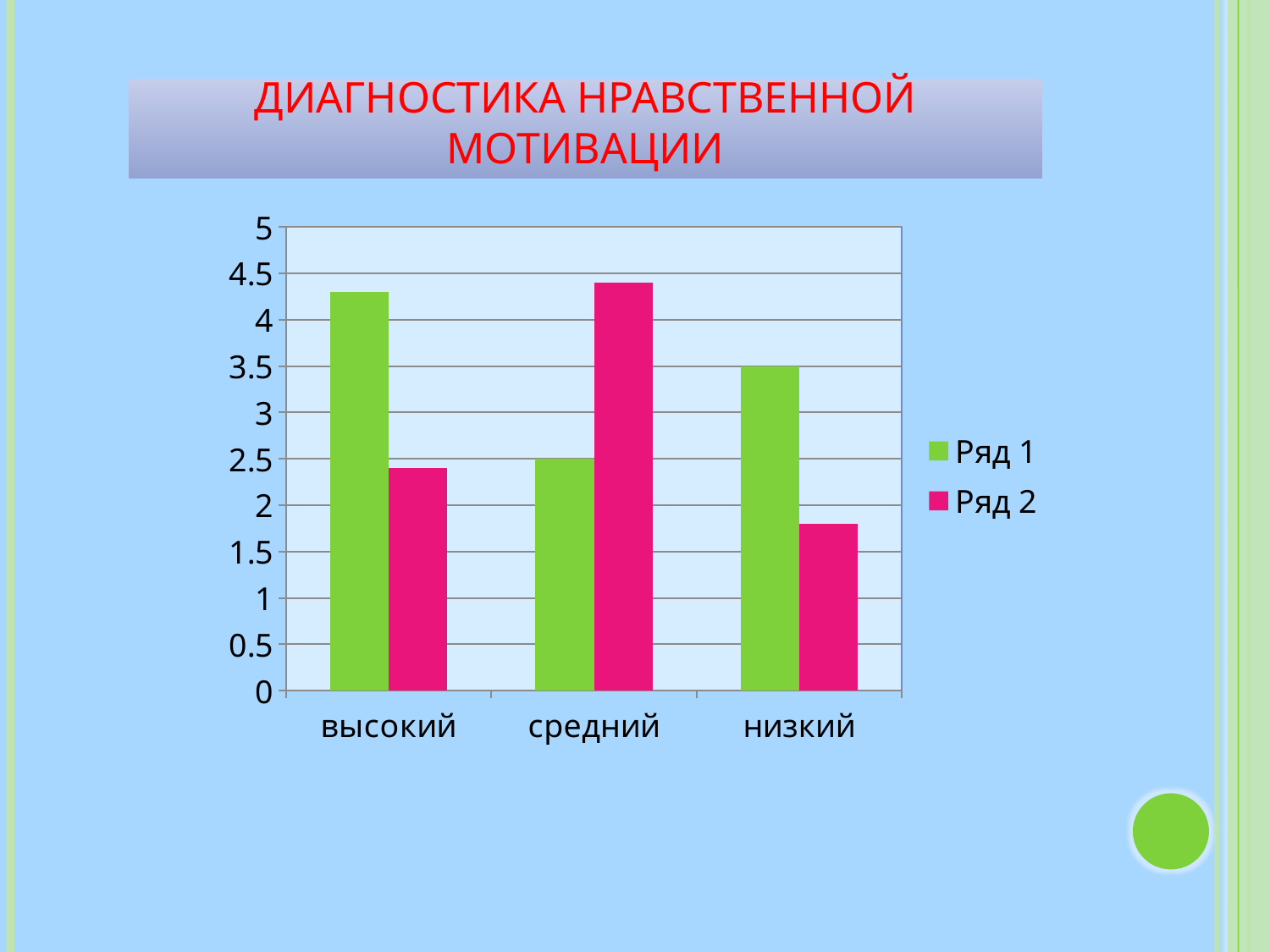
Which category has the lowest value for Ряд 2? низкий Is the value of Ряд 1 for высокий greater or less than 4? greater How many categories are shown on the x axis of the chart? 3 What is the value of Ряд 1 for низкий? 3.5 What colour are the bars for Ряд 2? pink Is the value of Ряд 2 for средний greater or less than 4? greater Is the value of Ряд 2 for низкий greater or less than 2? less For the category высокий, which series has the larger value, Ряд 1 or Ряд 2? Ряд 1 What kind of chart is shown on the slide? bar chart Which category has the highest value for Ряд 1? высокий What is the value of Ряд 1 for средний? 2.5 How many series does the legend list? 2